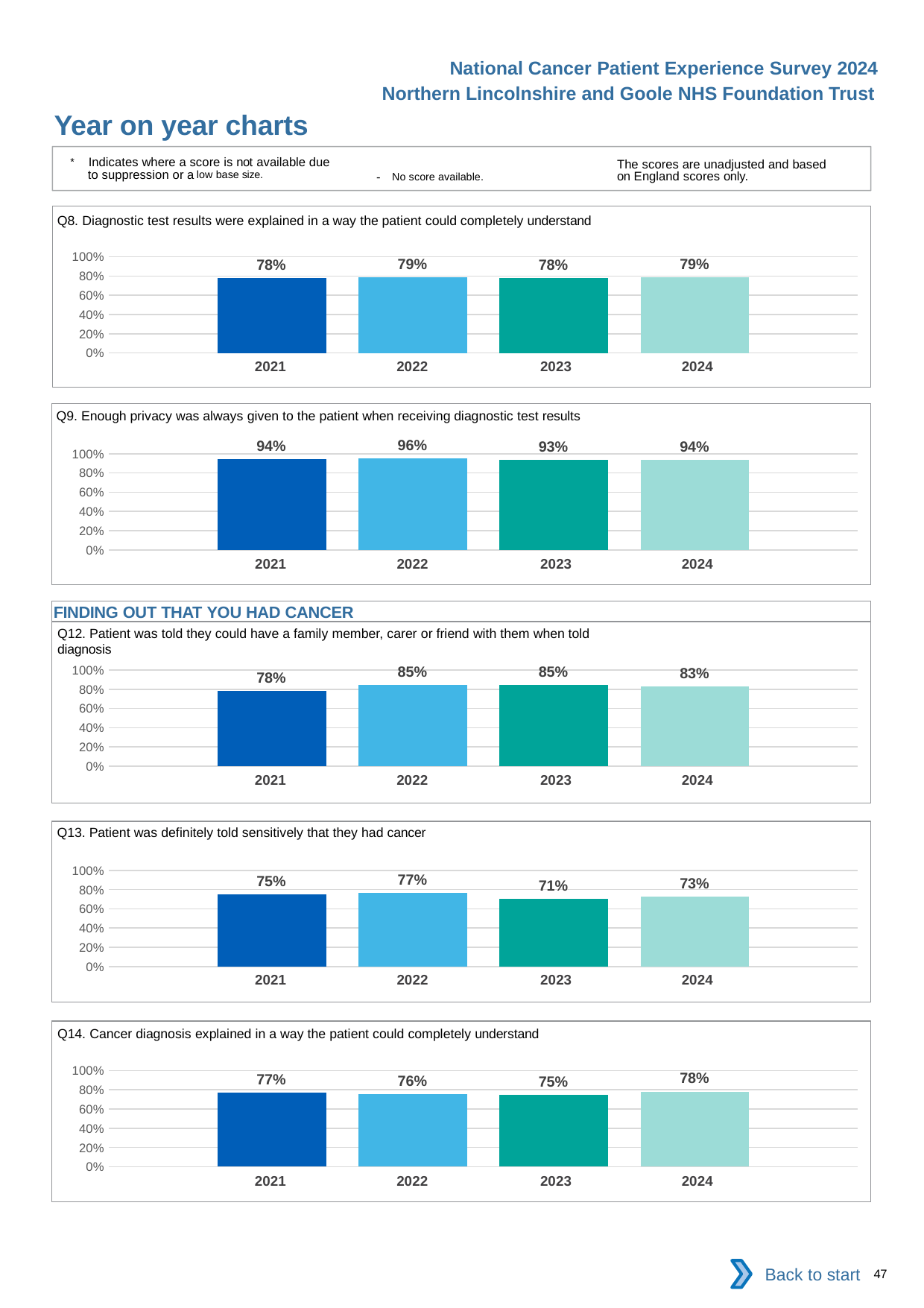
In the Q14 chart (Cancer diagnosis explained in a way the patient could completely understand), what is the difference between the 2024 value and the 2023 value? 3% What kind of chart is the Q12 chart (Patient was told they could have a family member, carer or friend with them when told diagnosis)? Bar chart How many years are shown in the Q8 chart (Diagnostic test results were explained in a way the patient could completely understand)? 4 In the Q13 chart (Patient was definitely told sensitively that they had cancer), what is the value for 2024? 73% How many charts are shown on the slide? 5 In the Q13 chart (Patient was definitely told sensitively that they had cancer), is the value for 2023 greater or less than 80%? less In the Q14 chart (Cancer diagnosis explained in a way the patient could completely understand), which year has the highest value? 2024 In the Q8 chart (Diagnostic test results were explained in a way the patient could completely understand), what is the value for 2022? 79% In the Q9 chart (Enough privacy was always given to the patient when receiving diagnostic test results), which year has the lowest value? 2023 In the Q13 chart (Patient was definitely told sensitively that they had cancer), which is larger, the value for 2022 or the value for 2023? 2022 In the Q12 chart (Patient was told they could have a family member, carer or friend with them when told diagnosis), what is the difference between the 2022 value and the 2021 value? 7% In the Q9 chart (Enough privacy was always given to the patient when receiving diagnostic test results), which year has the highest value? 2022